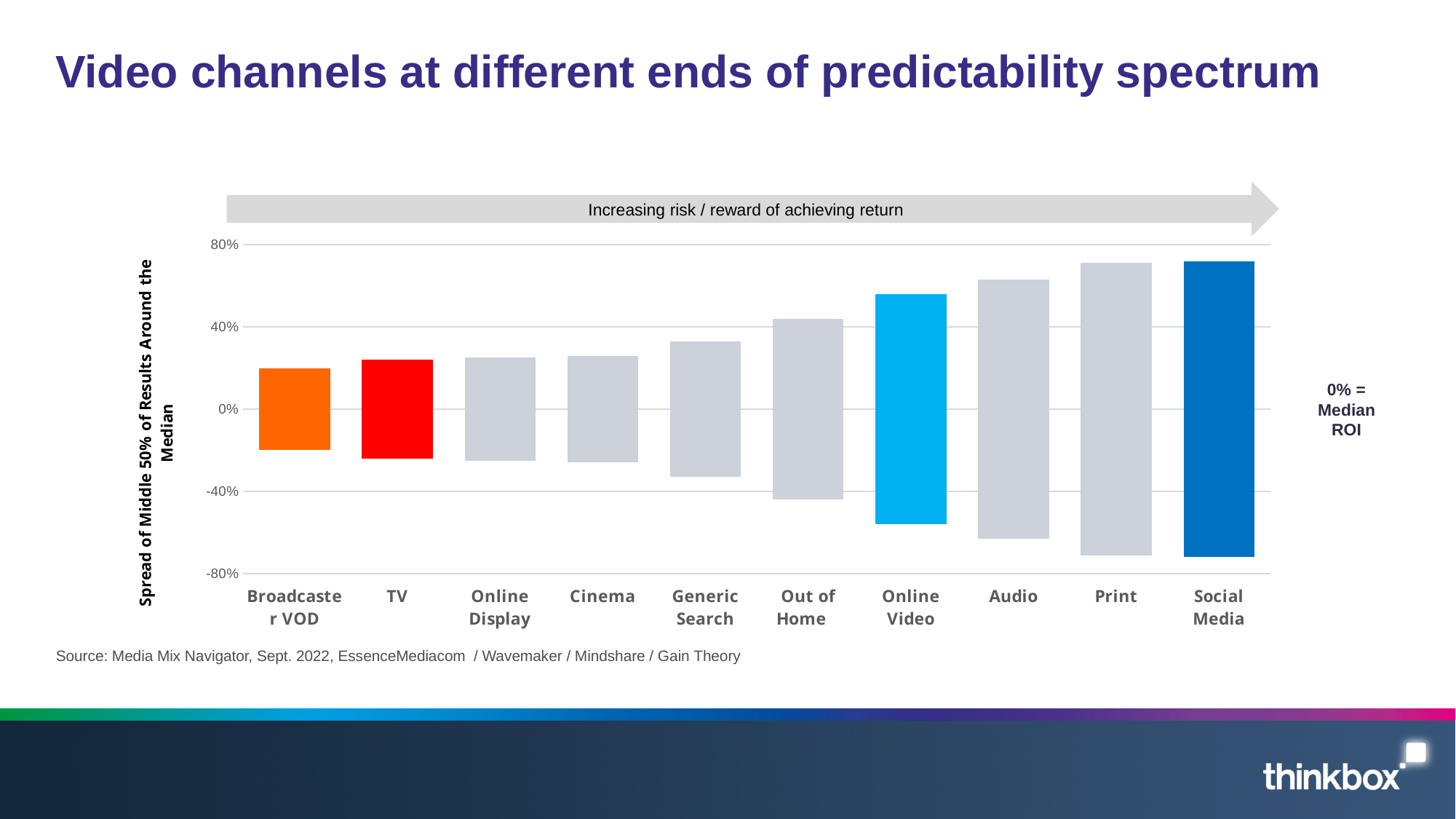
Does the spread of results around the median increase or decrease moving from left to right along the x axis? Increase Is the upper end of the TV bar greater or less than 40%? less Is the upper end of the Broadcaster VOD bar greater or less than 40%? less How many media channels are shown on the x axis of the chart? 10 Is the lower end of the Print bar greater or less than -40%? less Which has the wider spread of results around the median: Audio or Cinema? Audio Which has the wider spread of results around the median: Social Media or Broadcaster VOD? Social Media What is the label on the y axis of the chart? Spread of Middle 50% of Results Around the Median What kind of chart is shown on the slide? Bar chart